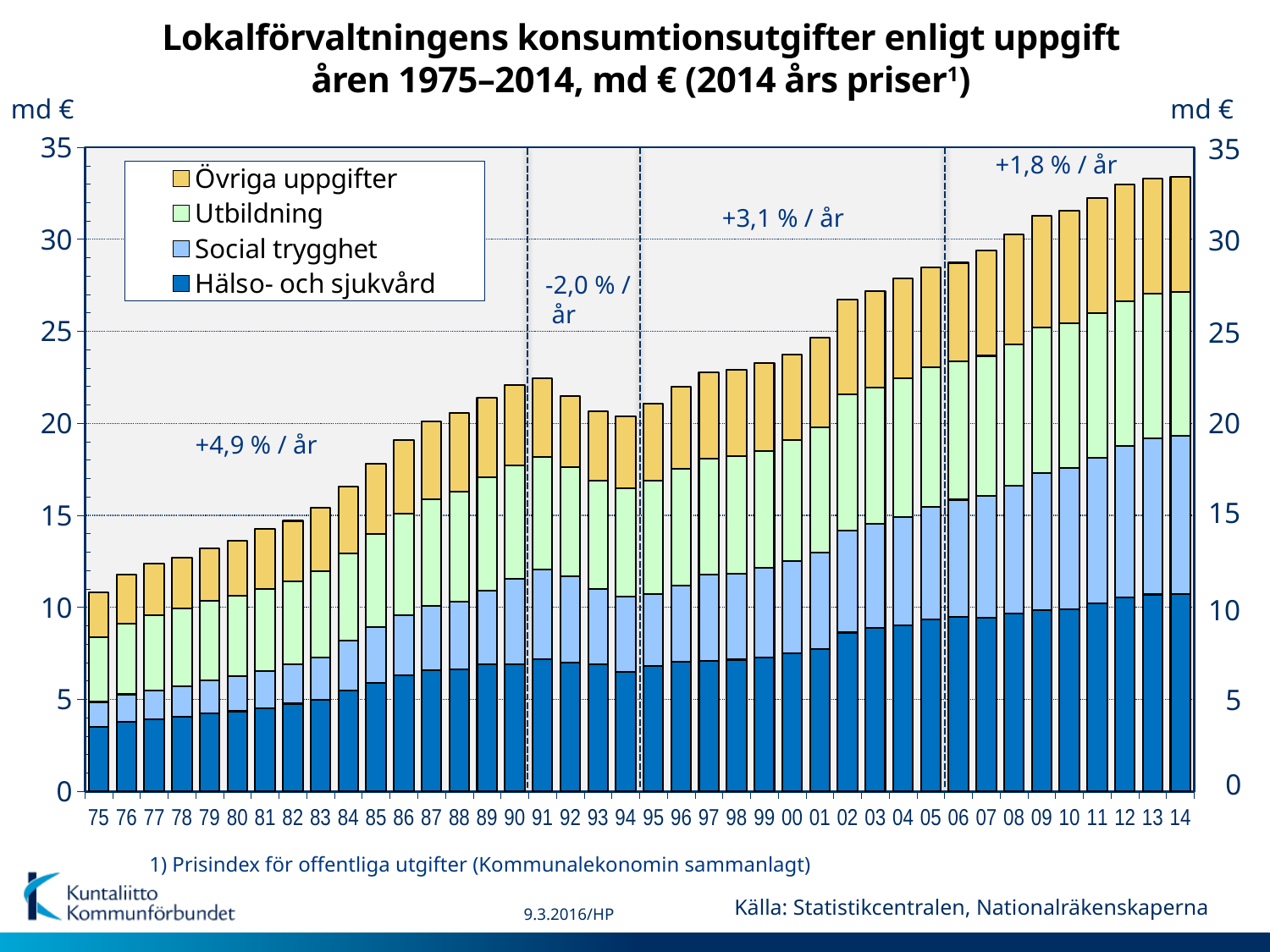
What annual growth rate is annotated for the period 1975–1990? +4,9 % / år Do the total bars generally rise or fall from 75 to 14? rise Is the total bar for 85 greater or less than 20? less Which year has the larger total bar, 90 or 94? 90 Which year has the lowest total consumption expenditure? 75 What kind of chart is shown on the slide? Stacked bar chart Is the Hälso- och sjukvård value for 75 greater or less than 5? less Which series is shown at the bottom of each stacked bar? Hälso- och sjukvård How many years (bars) are plotted on the chart? 40 Is the total bar for 75 greater or less than 15? less How many series does the legend list? 4